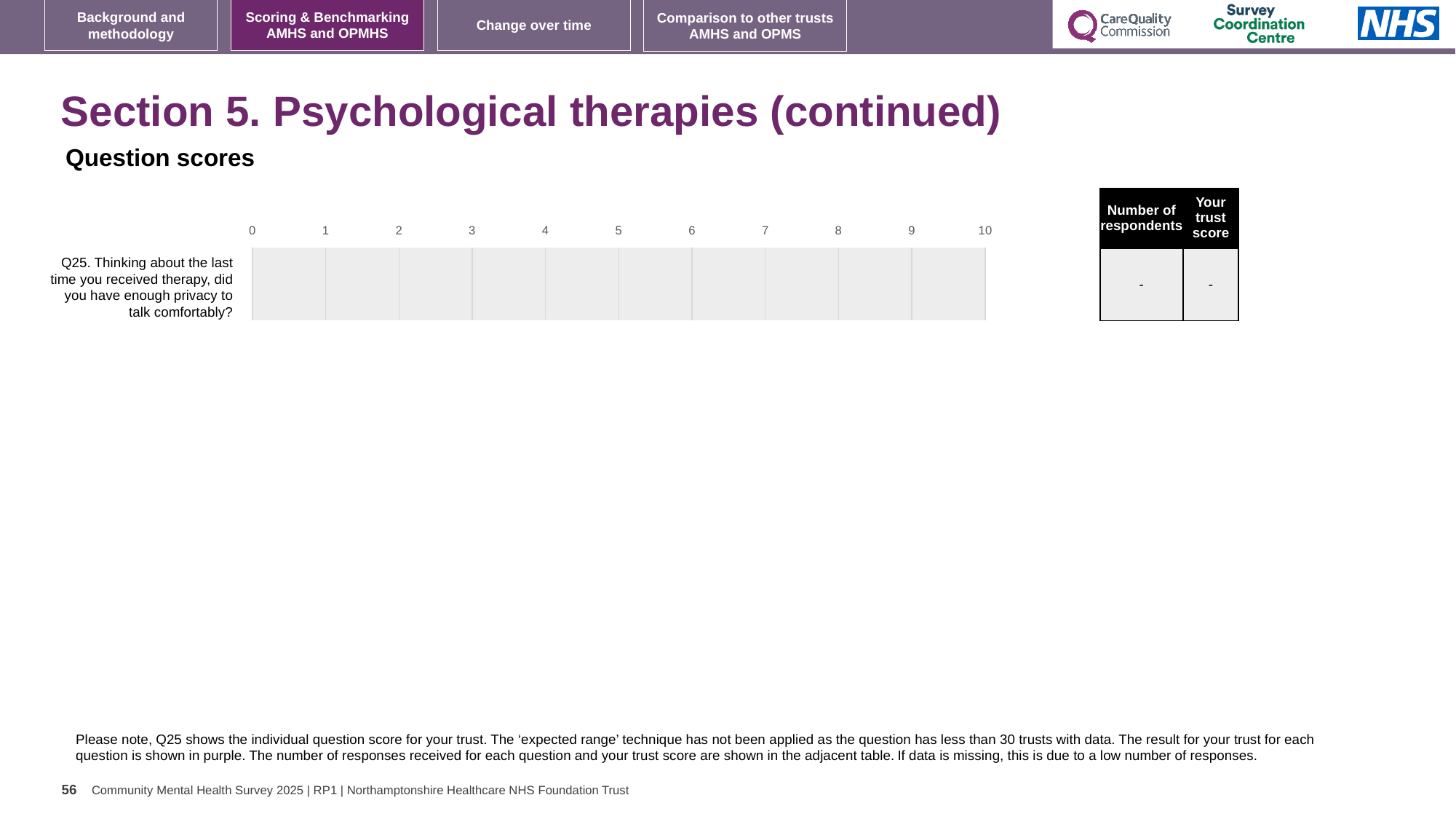
What kind of chart is shown on the slide? bar chart Which question is listed on the chart? Q25. Thinking about the last time you received therapy, did you have enough privacy to talk comfortably? What is shown in the 'Number of respondents' column of the table for Q25? - How many questions (categories) are listed on the chart's vertical axis? 1 What is shown in the 'Your trust score' column of the table for Q25? - What is the highest value shown on the chart's horizontal axis? 10